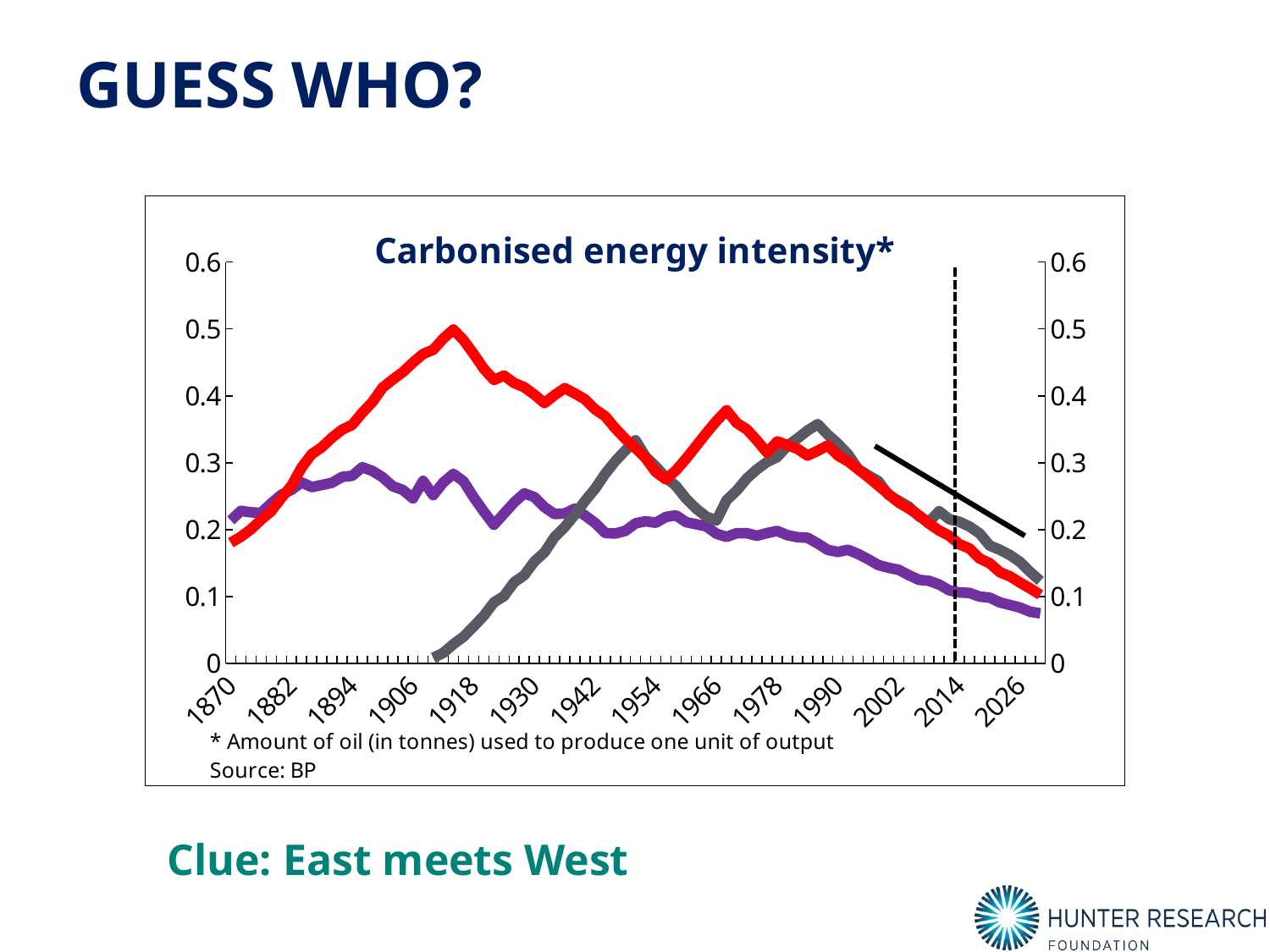
How many coloured data lines are plotted on the chart? 3 Does the red line rise or fall between 1990 and 2026? fall What kind of chart is shown on the slide? line chart What source is cited for the chart? BP Which coloured line reaches the highest value on the chart? red At 1918, which line is higher, the red line or the purple line? red What is the title of the chart? Carbonised energy intensity* Is the peak value of the red line around 1918 greater or less than 0.4? greater At 1990, which line is higher, the grey line or the red line? grey Is the peak value of the grey line around 1990 greater or less than 0.3? greater How many year labels are shown on the x axis? 14 Is the value of the purple line at 2026 greater or less than 0.1? less